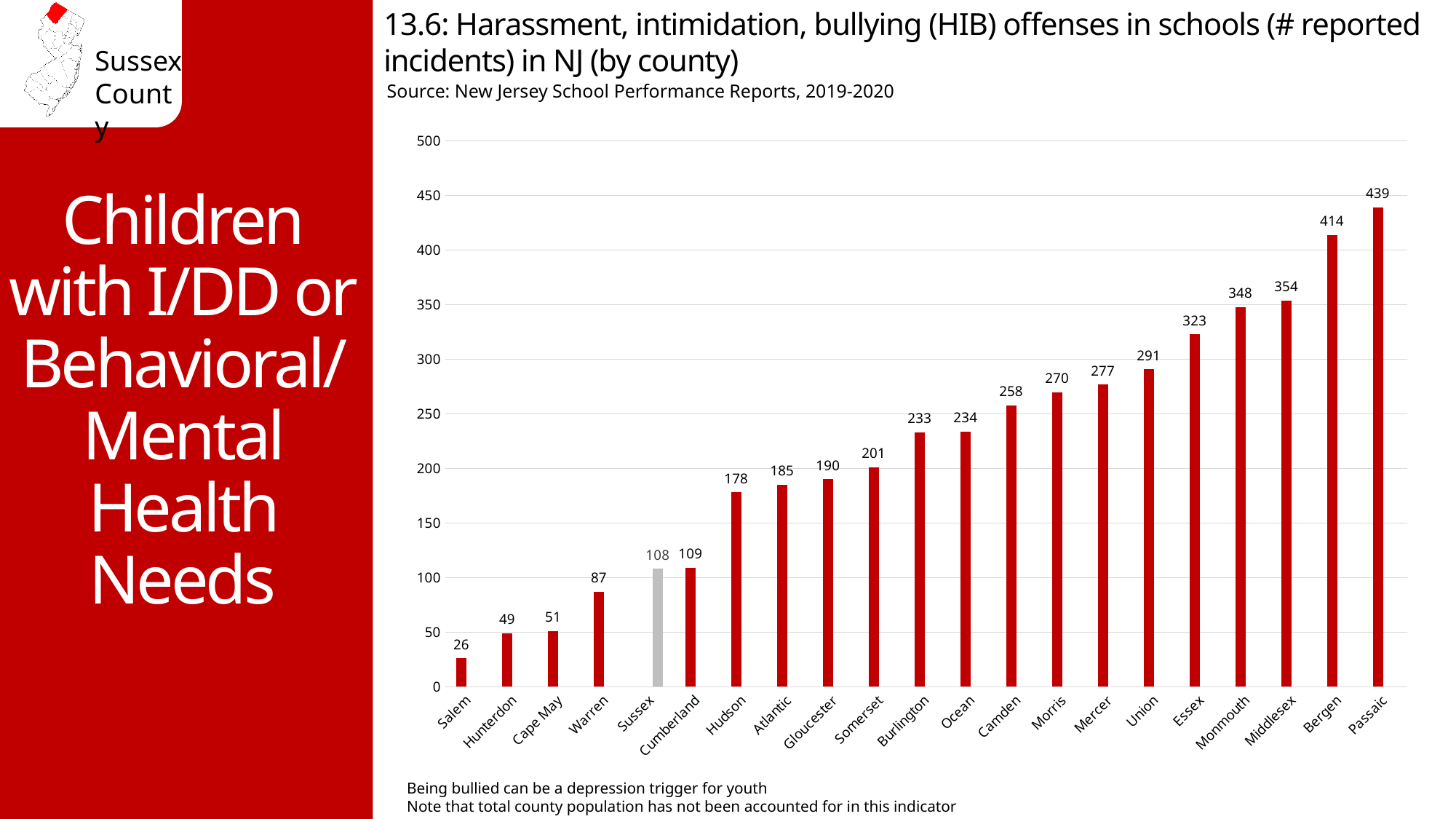
What is the value shown for Hudson? 178 Which county has the highest number of reported HIB incidents? Passaic What is the value shown for Passaic? 439 Is the value for Union greater or less than 300? less What is the difference between the values for Bergen and Passaic? 25 What is the difference between the values for Sussex and Cumberland? 1 Which county has the lowest number of reported HIB incidents? Salem How many HIB incidents were reported for Sussex County? 108 Which has a higher value, Essex or Monmouth? Monmouth How many counties are shown on the x axis? 21 Which bar is coloured grey instead of red? Sussex What kind of chart is this? bar chart